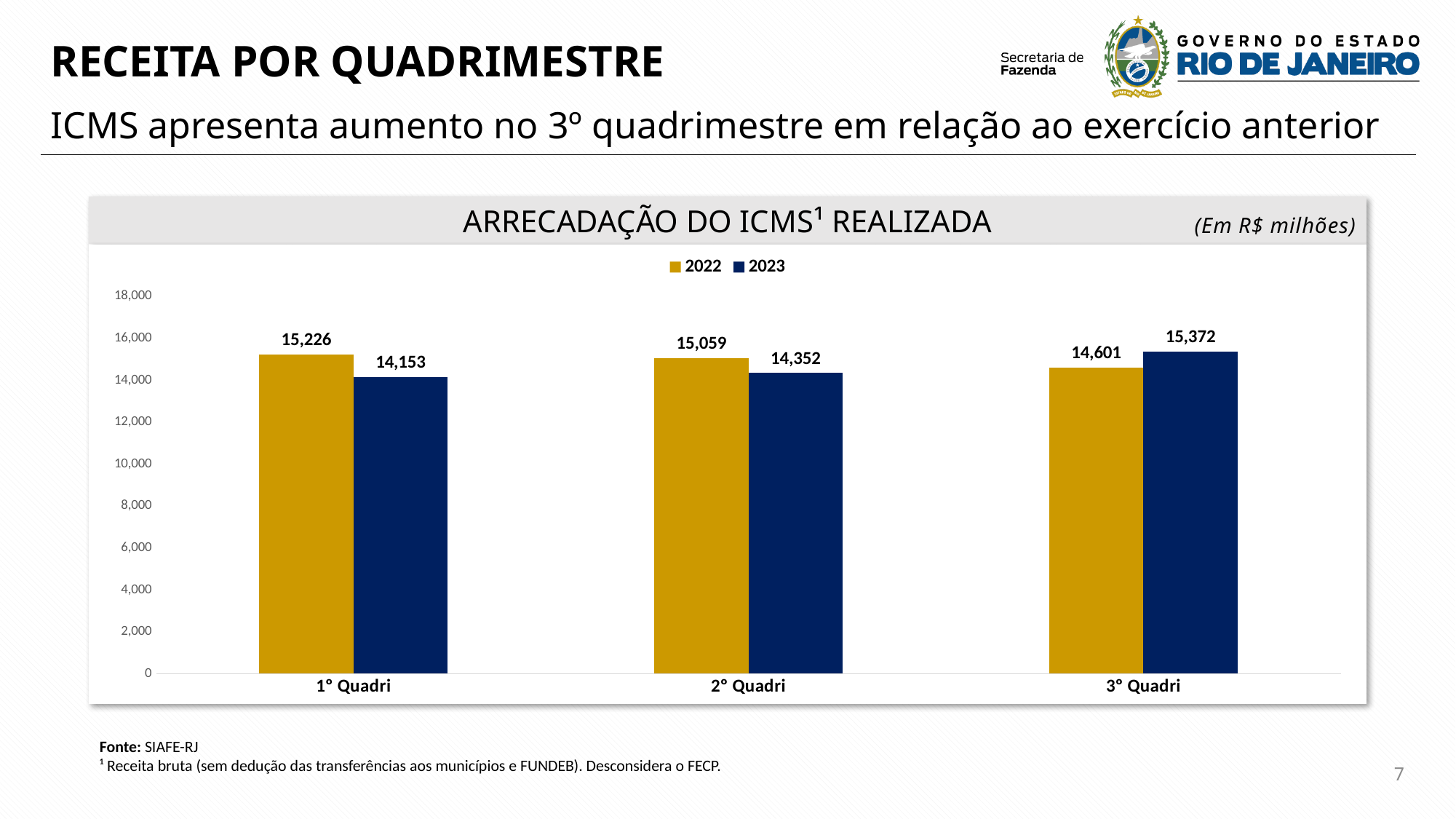
Which quadrimester has the lowest 2022 value? 3° Quadri What is the difference between the 2023 and 2022 values for 3° Quadri? 771 What is the 2022 value for 1° Quadri? 15,226 What is the 2023 value for 3° Quadri? 15,372 Which quadrimester has the highest 2023 value? 3° Quadri How many quadrimesters are shown on the x axis? 3 What kind of chart is shown? Bar chart What is the 2023 value for 2° Quadri? 14,352 How many series does the legend list? 2 Which is larger for 2° Quadri, the 2022 value or the 2023 value? 2022 What is the difference between the 2022 and 2023 values for 1° Quadri? 1,073 What is the title of the chart? ARRECADAÇÃO DO ICMS¹ REALIZADA